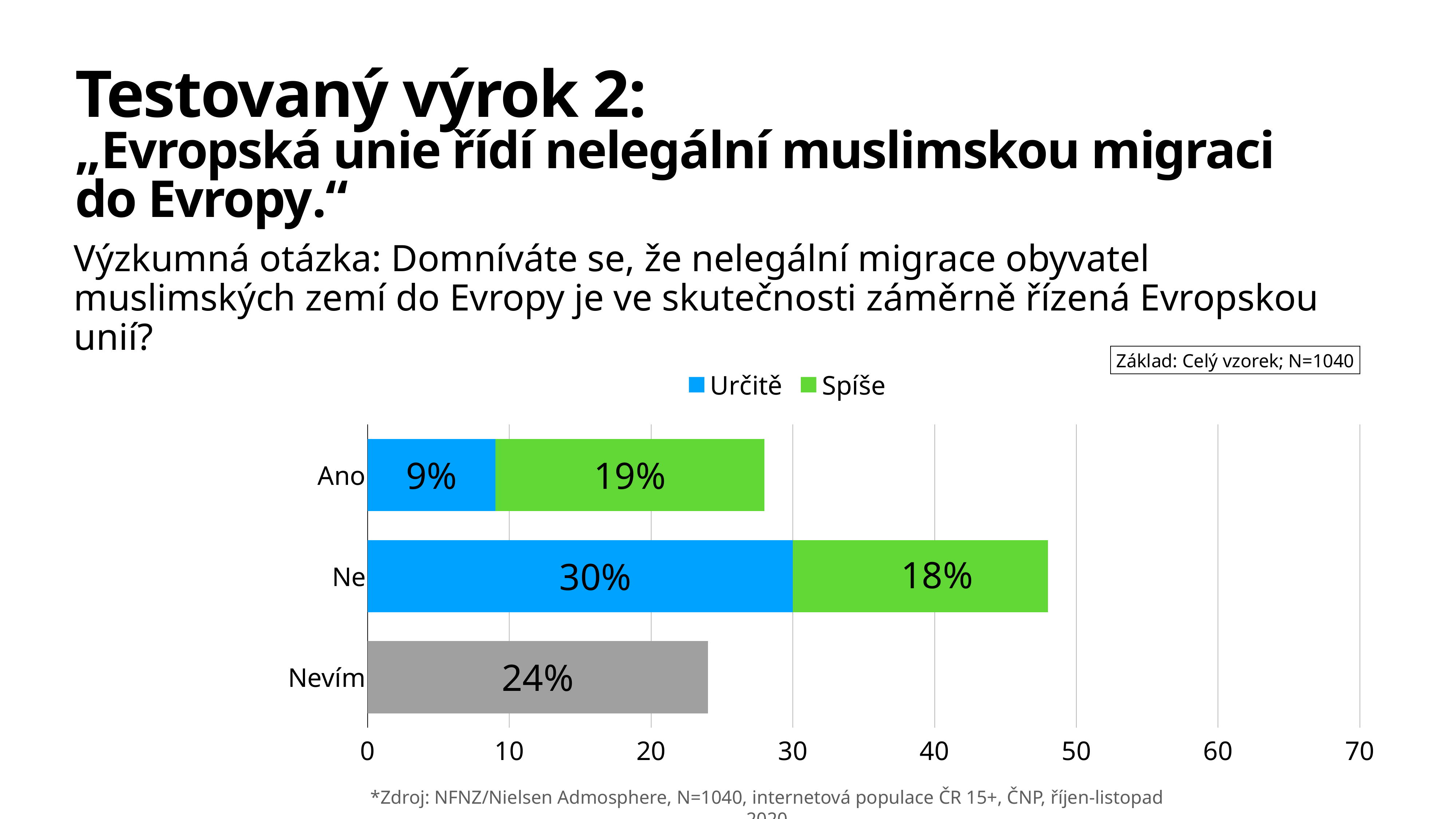
Which category has the highest Určitě value? Ne What is the value of the Určitě series for the Ano category? 9% What is the difference between the Určitě values for Ne and Ano? 21% What is the total of the stacked bar for the Ano category? 28% What is the total of the stacked bar for the Ne category? 48% What is the value of the Spíše series for the Ne category? 18% Which is larger: the Spíše value for Ano or the Spíše value for Ne? Ano How many categories are shown on the y axis of the chart? 3 What is the value of the Určitě series for the Ne category? 30% How many series does the legend list? 2 What is the value shown for the Nevím category? 24% What kind of chart is shown on the slide? Bar chart